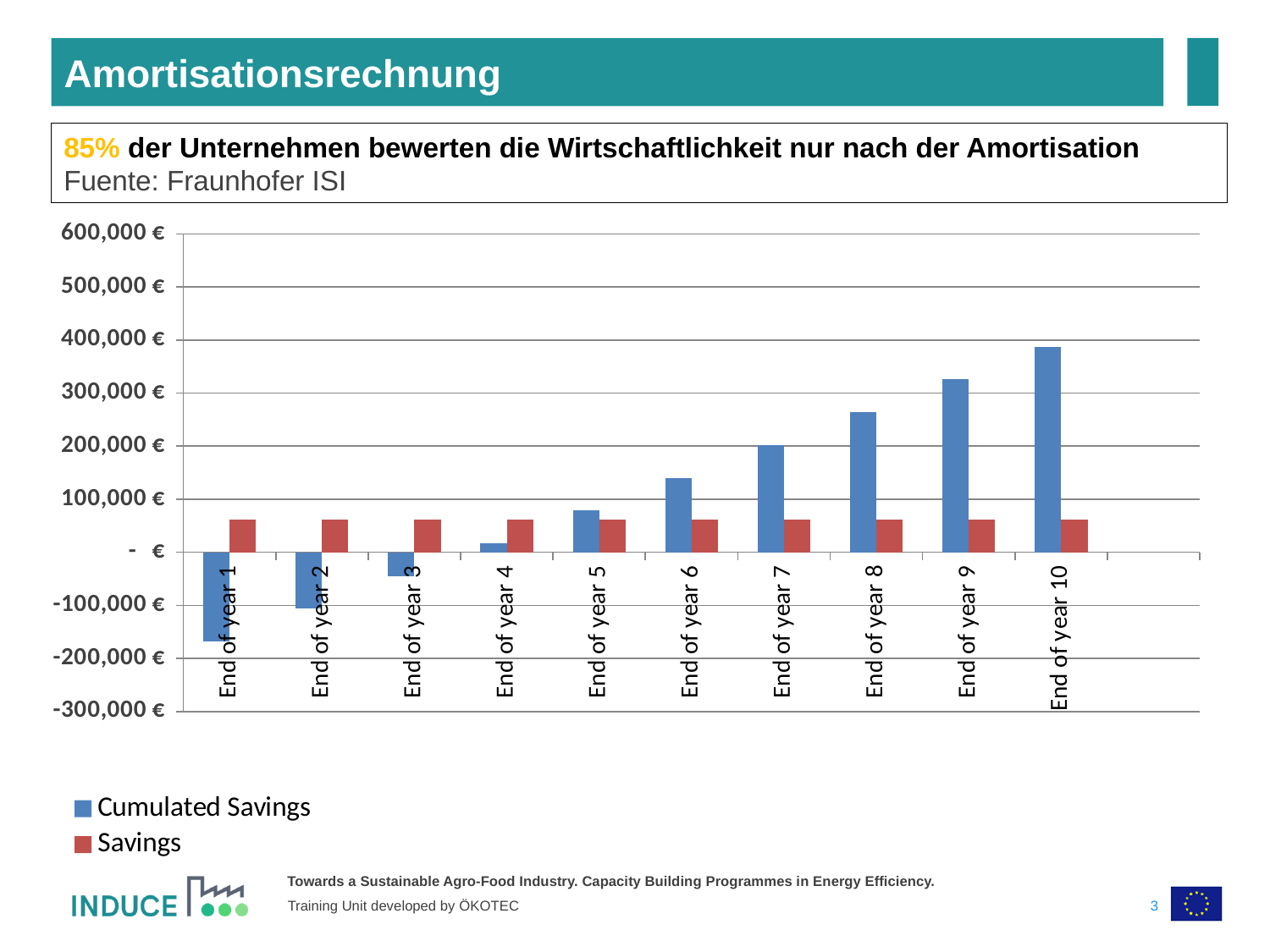
Is the Cumulated Savings value for End of year 8 greater or less than 200,000 €? greater Which is larger at End of year 9: Cumulated Savings or Savings? Cumulated Savings How many series does the legend list? 2 Is the Cumulated Savings value for End of year 1 greater or less than -100,000 €? less Is the Cumulated Savings value for End of year 10 greater or less than 300,000 €? greater Do the Cumulated Savings values rise or fall from End of year 1 to End of year 10? rise Which category has the highest Cumulated Savings value? End of year 10 What kind of chart is shown on the slide? bar chart How many categories (years) are shown on the x axis? 10 Which series is shown in blue in the legend? Cumulated Savings Which category has the lowest Cumulated Savings value? End of year 1